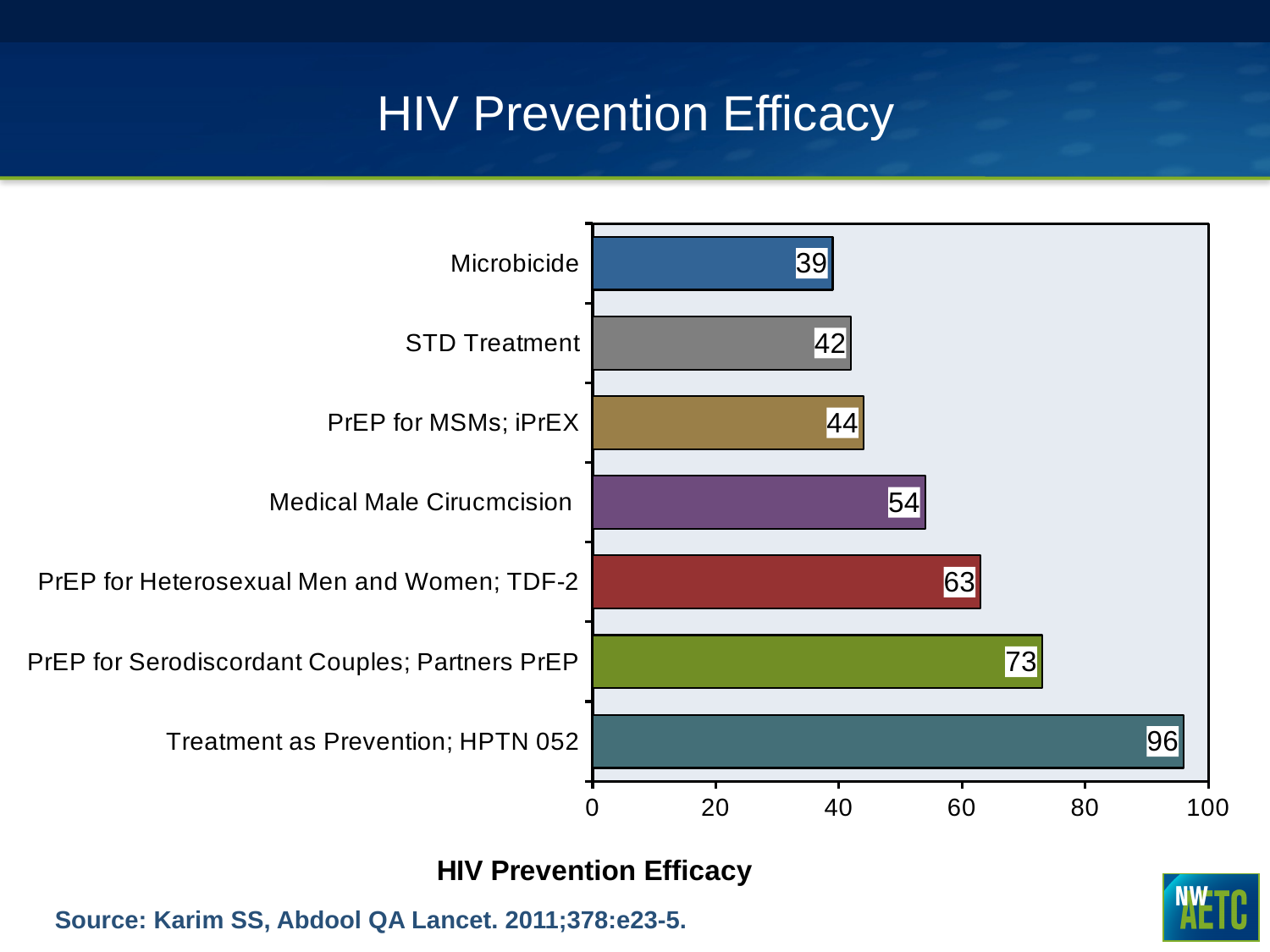
What kind of chart is shown on the slide? bar chart What is the difference between the values for PrEP for Heterosexual Men and Women; TDF-2 and STD Treatment? 21 Is the value for PrEP for Heterosexual Men and Women; TDF-2 greater or less than 60? greater Which category has the highest value? Treatment as Prevention; HPTN 052 Which category has the lowest value? Microbicide What is the value shown for PrEP for Serodiscordant Couples; Partners PrEP? 73 How many categories are shown in the chart? 7 What is the difference between the values for Treatment as Prevention; HPTN 052 and PrEP for Serodiscordant Couples; Partners PrEP? 23 What is the HIV prevention efficacy value for Microbicide? 39 What is the label on the horizontal axis of the chart? HIV Prevention Efficacy Which is larger, the value for PrEP for MSMs; iPrEX or the value for Medical Male Cirucmcision? Medical Male Cirucmcision What is the value shown for Medical Male Cirucmcision? 54